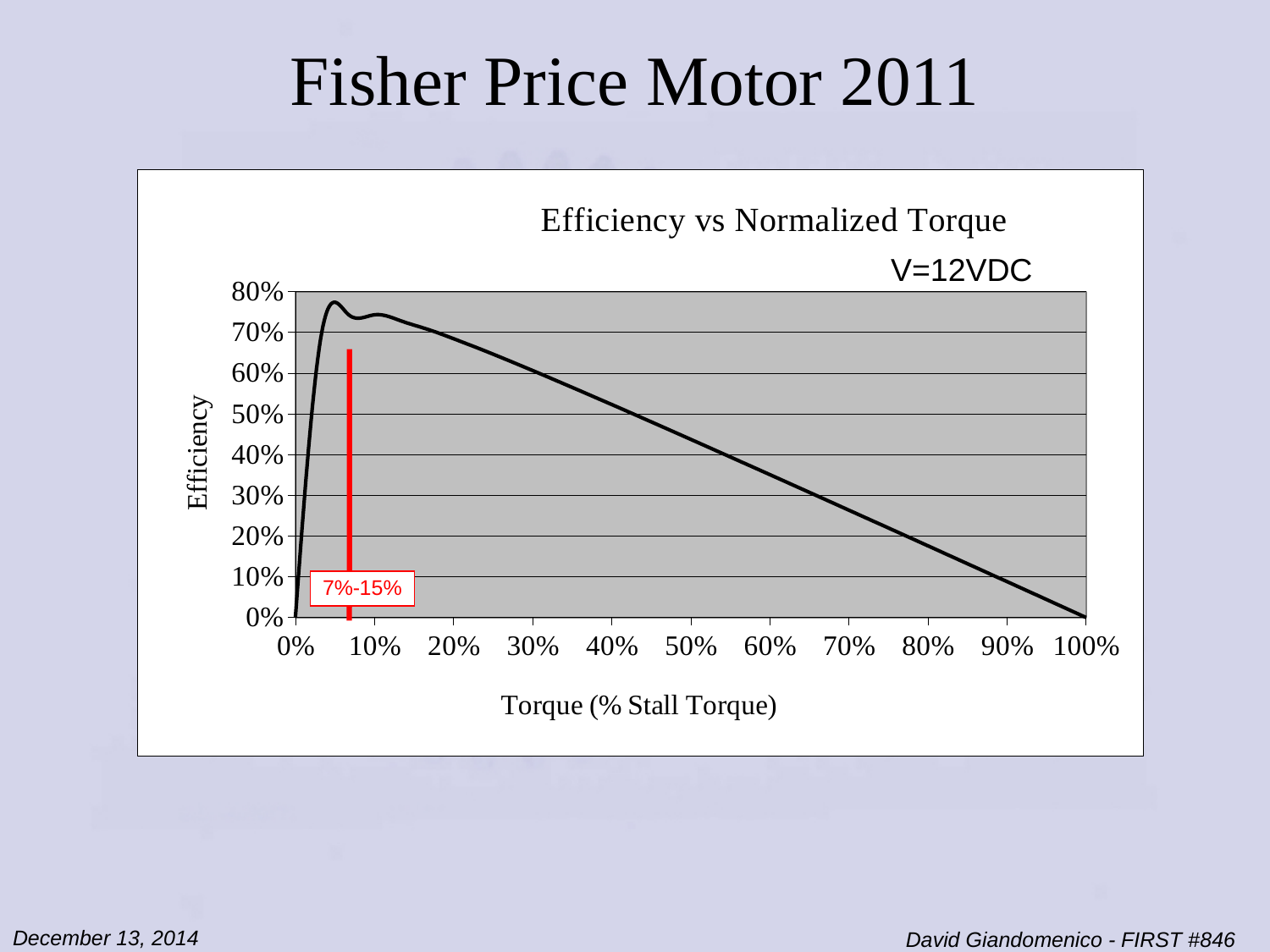
Is the efficiency at 60% torque greater or less than 50%? less What voltage is noted on the chart? V=12VDC Is the efficiency at 80% torque greater or less than 10%? greater What is the title of the chart? Efficiency vs Normalized Torque Is the efficiency at 80% torque greater or less than 30%? less Which has the higher efficiency: 30% torque or 70% torque? 30% torque What torque range is marked by the red label on the chart? 7%-15% What is the efficiency when torque is 100% of stall torque? 0% Does efficiency rise or fall as torque increases from 20% to 100% of stall torque? fall What kind of chart is shown on the slide? line chart